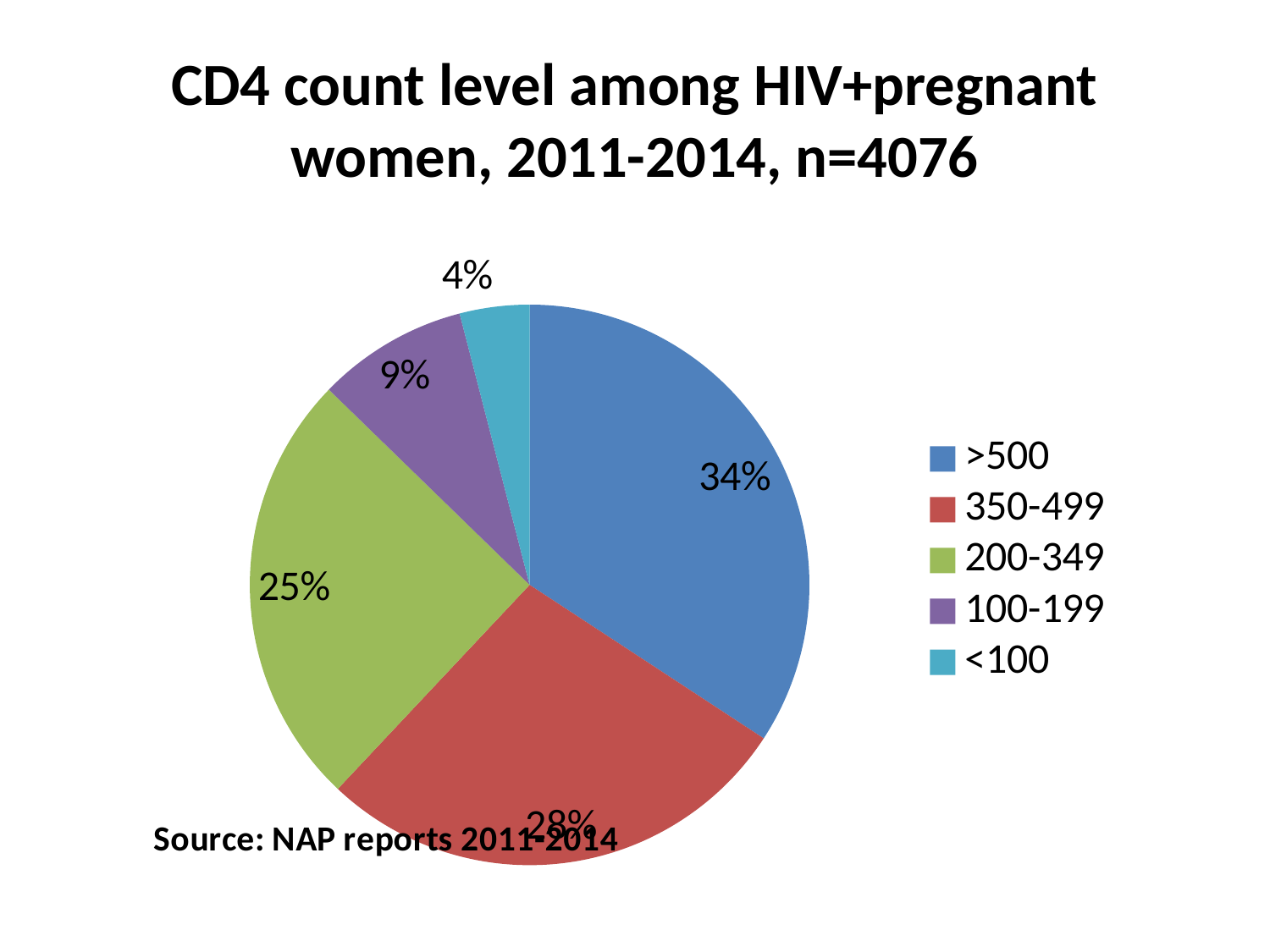
What type of chart is shown on the slide? pie chart Which CD4 count category has the smallest share of the pie? <100 What is the difference in percentage points between the >500 and 350-499 categories? 6 How many CD4 count categories are shown in the pie chart? 5 What share of HIV+ pregnant women had a CD4 count of 100-199? 9% Which CD4 count category has the largest share of the pie? >500 What share of HIV+ pregnant women had a CD4 count of >500? 34% What share of HIV+ pregnant women had a CD4 count of 350-499? 28% Which category has a larger share: 200-349 or 100-199? 200-349 What is the title of the chart? CD4 count level among HIV+pregnant women, 2011-2014, n=4076 What share of HIV+ pregnant women had a CD4 count of <100? 4% What share of HIV+ pregnant women had a CD4 count of 200-349? 25%